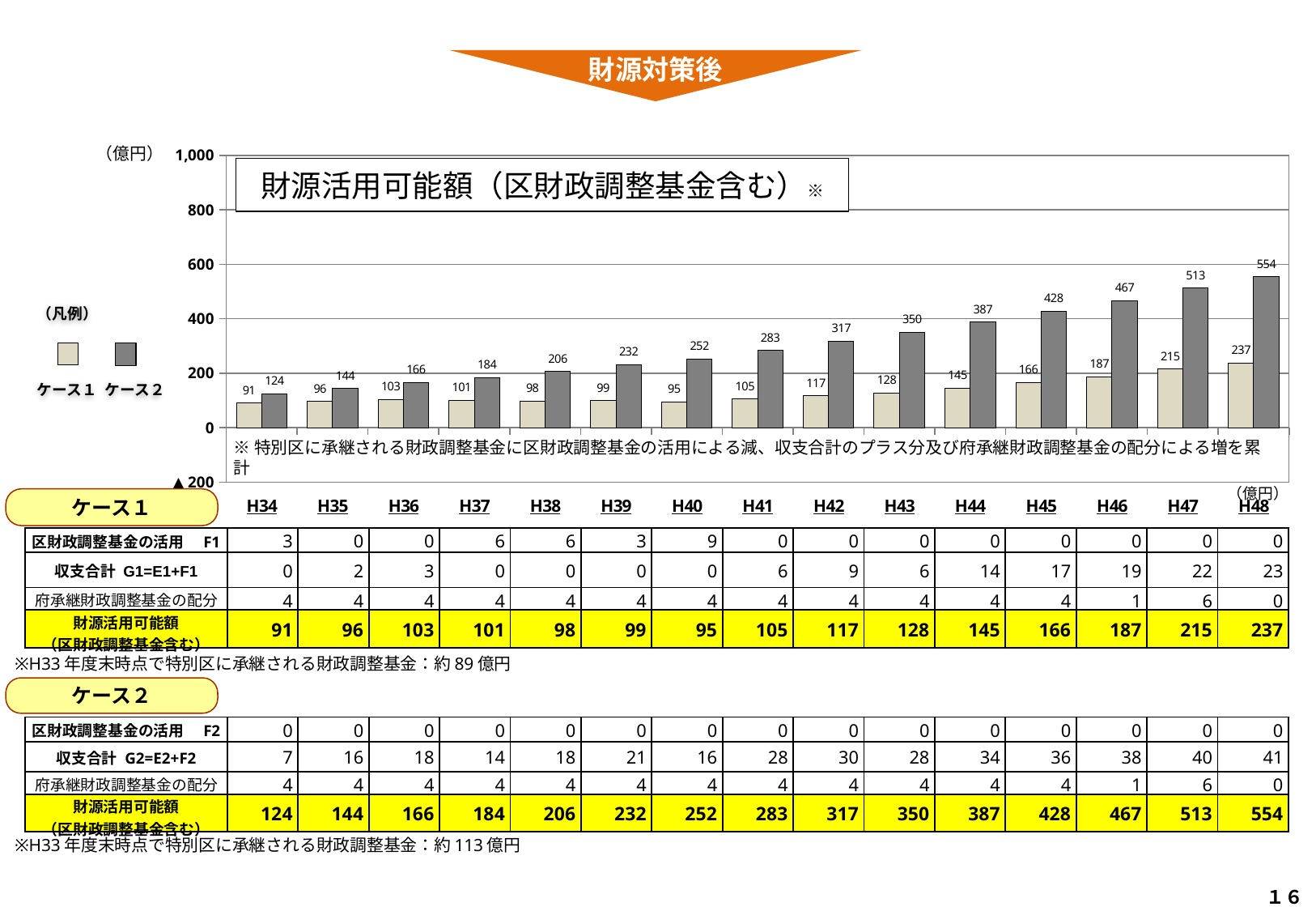
How many years are shown on the x axis of the chart? 15 What is the difference between ケース2 and ケース1 in H48? 317 In which year does ケース2 reach its highest value? H48 Do the ケース2 values rise or fall from H34 to H48? rise What is the title of the chart? 財源活用可能額（区財政調整基金含む） What is the value for ケース1 in H42? 117 What is the value for ケース2 in H40? 252 What kind of chart is shown on the slide? bar chart How many series does the legend list? 2 In which year is the ケース1 value lowest? H34 In H36, which is larger, ケース1 or ケース2? ケース2 Is the value for ケース2 in H45 greater or less than 400? greater